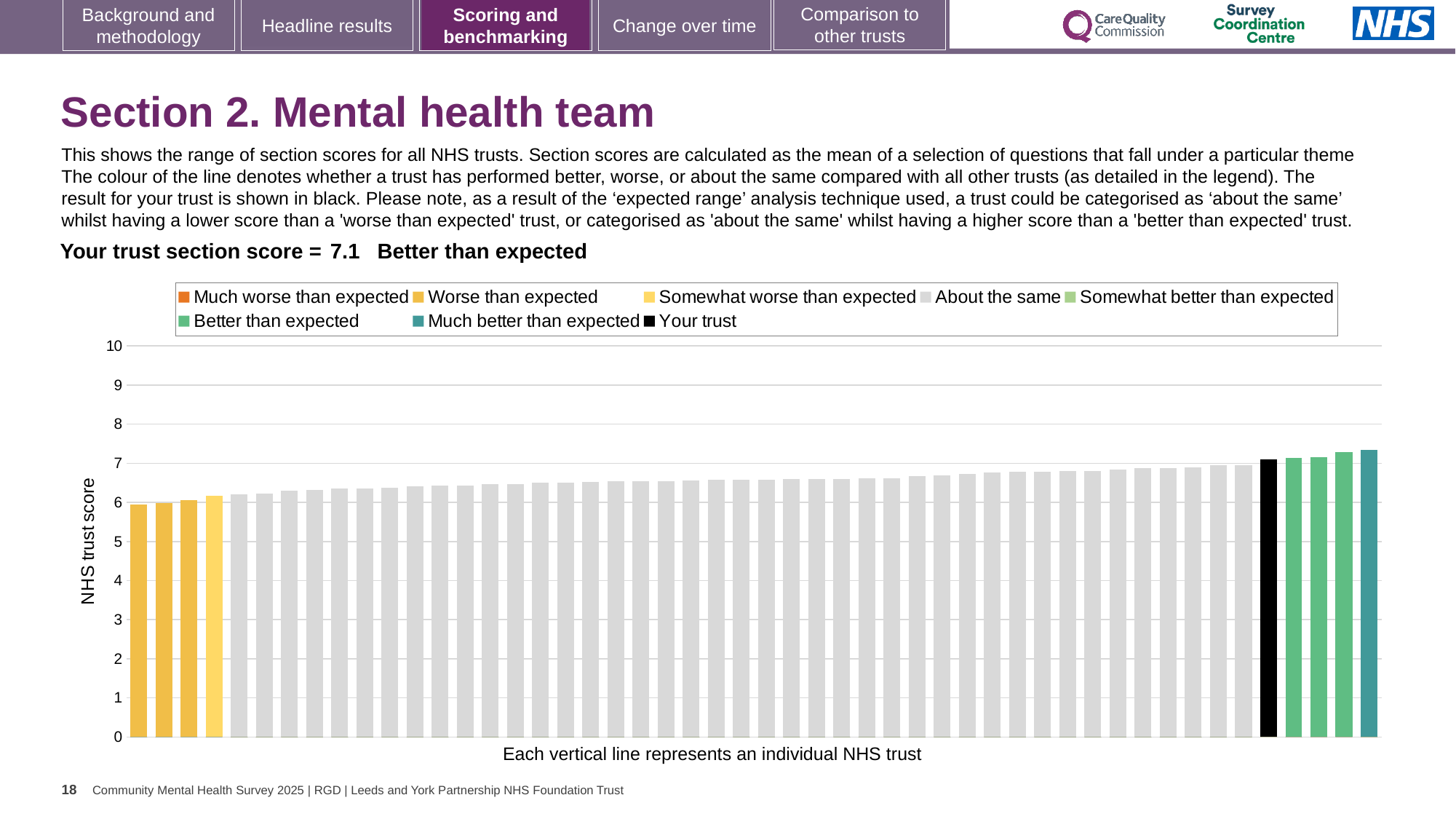
How many bars are coloured as 'Much better than expected' (teal)? 1 Do the bar values rise or fall from left to right along the x axis? rise Which is larger, the value for your trust's bar or the value of the leftmost bar? your trust's bar What kind of chart is shown on the slide? bar chart What colour is the bar representing your trust? black Is the value of the tallest bar in the chart greater or less than 7? greater What is the section score for your trust shown on the slide? 7.1 What is the label of the y axis? NHS trust score Is the value of the tallest bar in the chart greater or less than 8? less Is the value for your trust's bar greater or less than 6? greater How many entries does the chart legend list? 8 How many bars are coloured as 'Worse than expected' (dark yellow)? 3